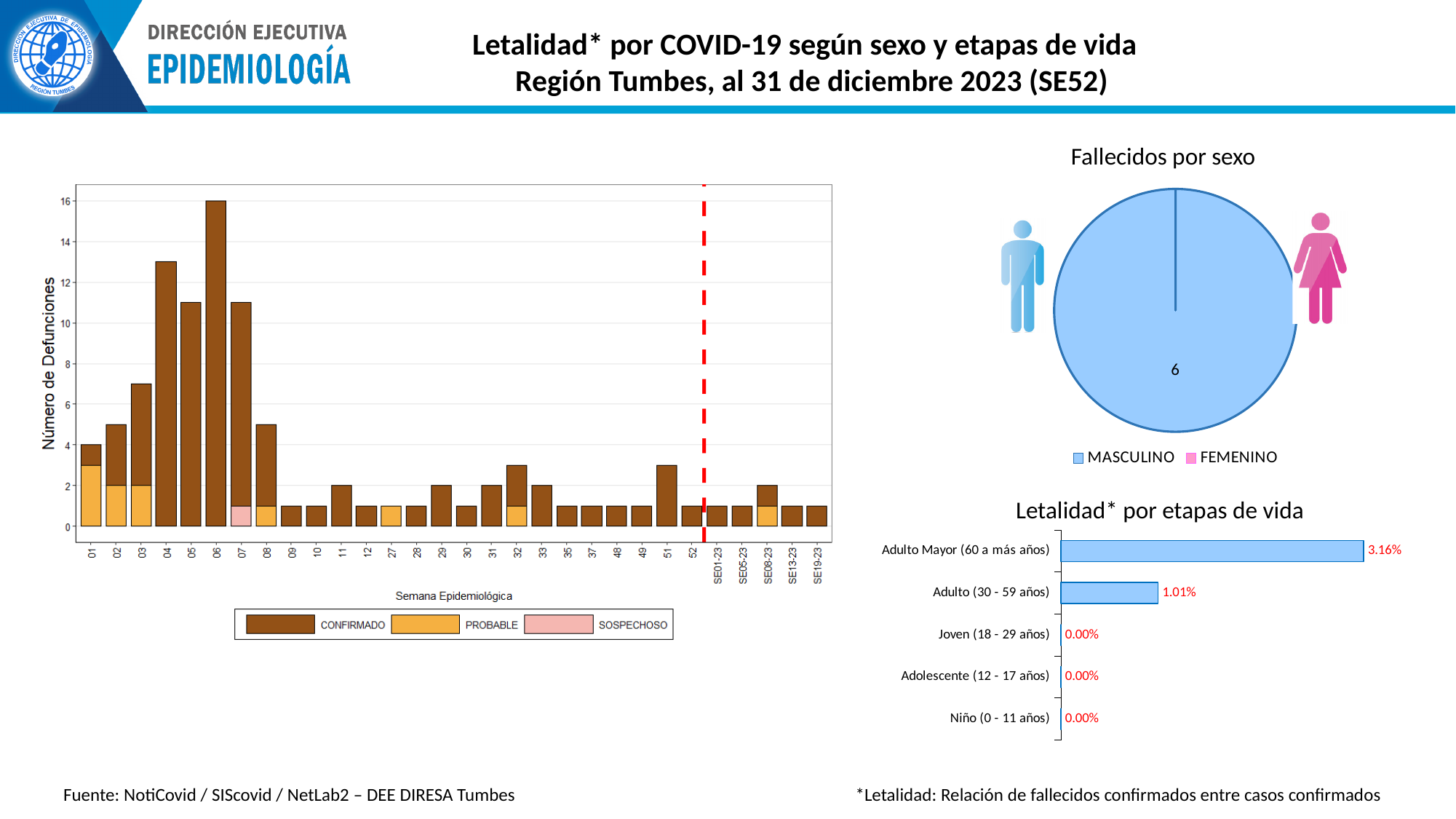
In the 'Letalidad* por etapas de vida' chart, what is the value for Joven (18 - 29 años)? 0.00% In the 'Letalidad* por etapas de vida' chart, what is the difference between the values for Adulto Mayor (60 a más años) and Adulto (30 - 59 años)? 2.15% What kind of chart is 'Letalidad* por etapas de vida'? Bar chart In the 'Letalidad* por etapas de vida' chart, what is the value for Adulto (30 - 59 años)? 1.01% In the 'Letalidad* por etapas de vida' chart, which age group has the highest value? Adulto Mayor (60 a más años) In the bar chart on the left (Número de Defunciones by Semana Epidemiológica), what is the total number of deaths in week 06? 16 In the 'Letalidad* por etapas de vida' chart, what is the value for Adulto Mayor (60 a más años)? 3.16% In the bar chart on the left (Número de Defunciones by Semana Epidemiológica), is the value for week 04 greater or less than 12? greater How many age groups are shown in the 'Letalidad* por etapas de vida' chart? 5 In the bar chart on the left (Número de Defunciones by Semana Epidemiológica), which epidemiological week has the highest number of deaths? 06 In the 'Fallecidos por sexo' pie chart, what value is shown for MASCULINO? 6 How many series does the legend of the 'Fallecidos por sexo' pie chart list? 2